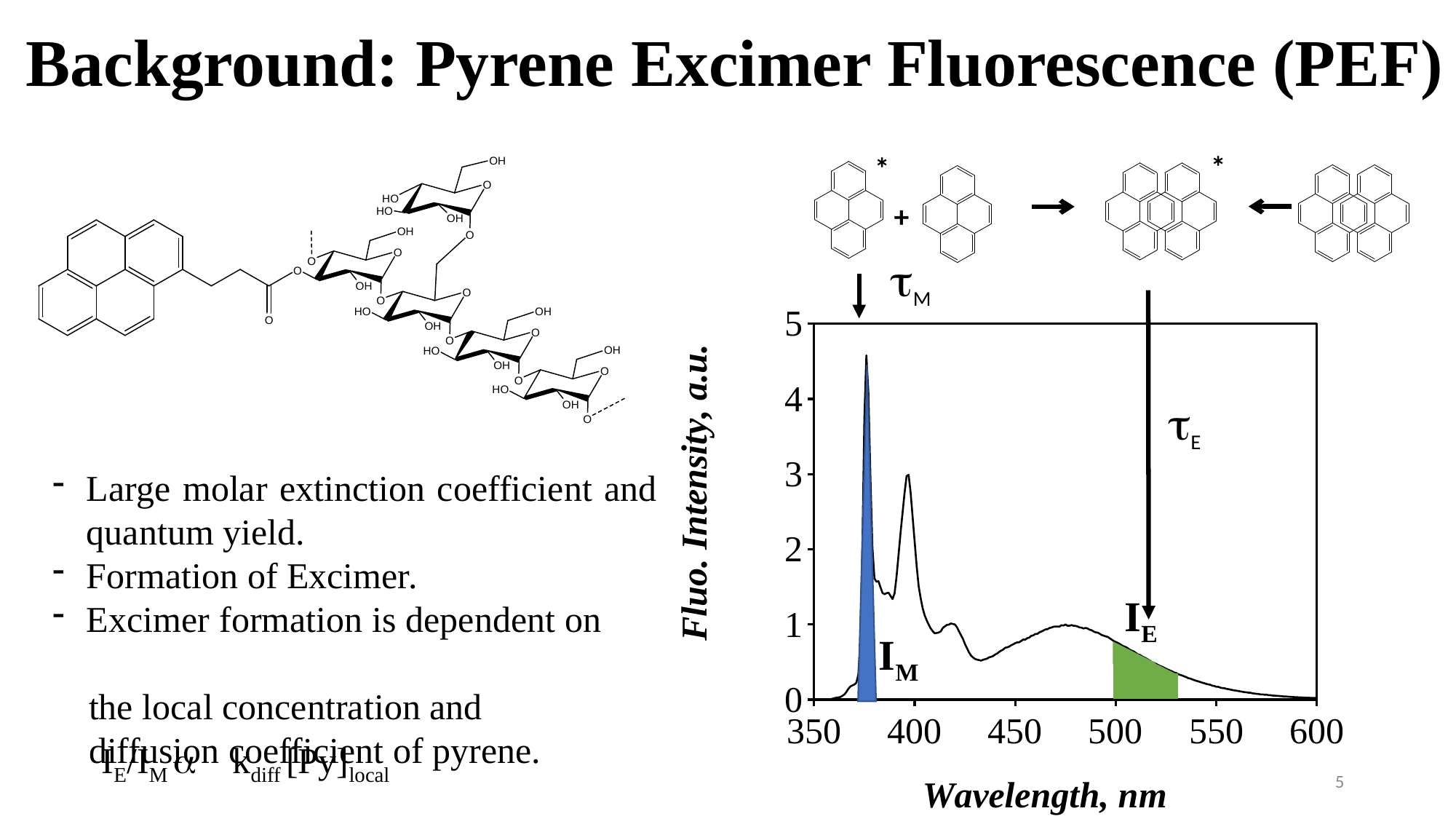
Is the fluorescence intensity at 450 nm greater or less than 2? less Is the fluorescence intensity at 600 nm greater or less than 1? less What is the title of the x axis of the chart? Wavelength, nm Does the fluorescence intensity rise or fall along the x axis between 500 nm and 600 nm? fall Is the highest peak of the fluorescence spectrum, near 375 nm, greater or less than 4? greater What is the title of the y axis of the chart? Fluo. Intensity, a.u. Does the fluorescence intensity rise or fall along the x axis between 350 nm and 375 nm? rise What kind of chart is shown on the slide? line chart What is the highest value shown on the y axis of the chart? 5 What is the lowest value shown on the x axis of the chart? 350 Which is larger, the fluorescence intensity at the peak near 375 nm or the intensity at the peak near 475 nm? the peak near 375 nm